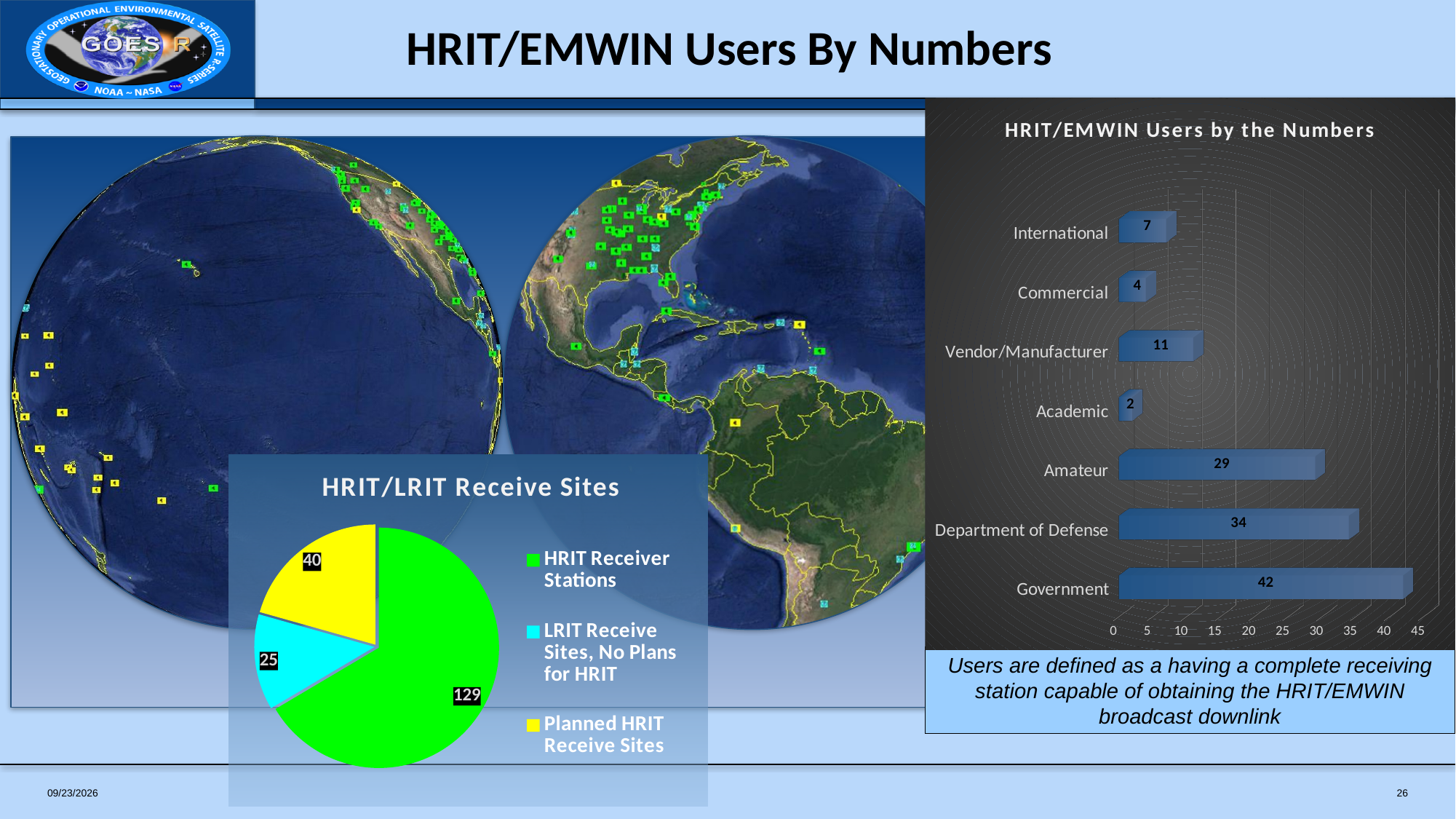
In the HRIT/EMWIN Users by the Numbers chart, what is the difference between Department of Defense and Amateur? 5 In the HRIT/EMWIN Users by the Numbers chart, what is the value for Government? 42 What kind of chart is the HRIT/EMWIN Users by the Numbers chart? Bar chart What kind of chart is the HRIT/LRIT Receive Sites chart? Pie chart In the HRIT/EMWIN Users by the Numbers chart, which category has the lowest value? Academic How many categories are shown in the HRIT/EMWIN Users by the Numbers chart? 7 In the HRIT/EMWIN Users by the Numbers chart, what is the value for Vendor/Manufacturer? 11 In the HRIT/LRIT Receive Sites chart, what is the value for HRIT Receiver Stations? 129 In the HRIT/EMWIN Users by the Numbers chart, which is larger, International or Commercial? International In the HRIT/LRIT Receive Sites chart, what is the difference between Planned HRIT Receive Sites and LRIT Receive Sites, No Plans for HRIT? 15 In the HRIT/LRIT Receive Sites chart, what is the value for Planned HRIT Receive Sites? 40 In the HRIT/EMWIN Users by the Numbers chart, which category has the highest value? Government